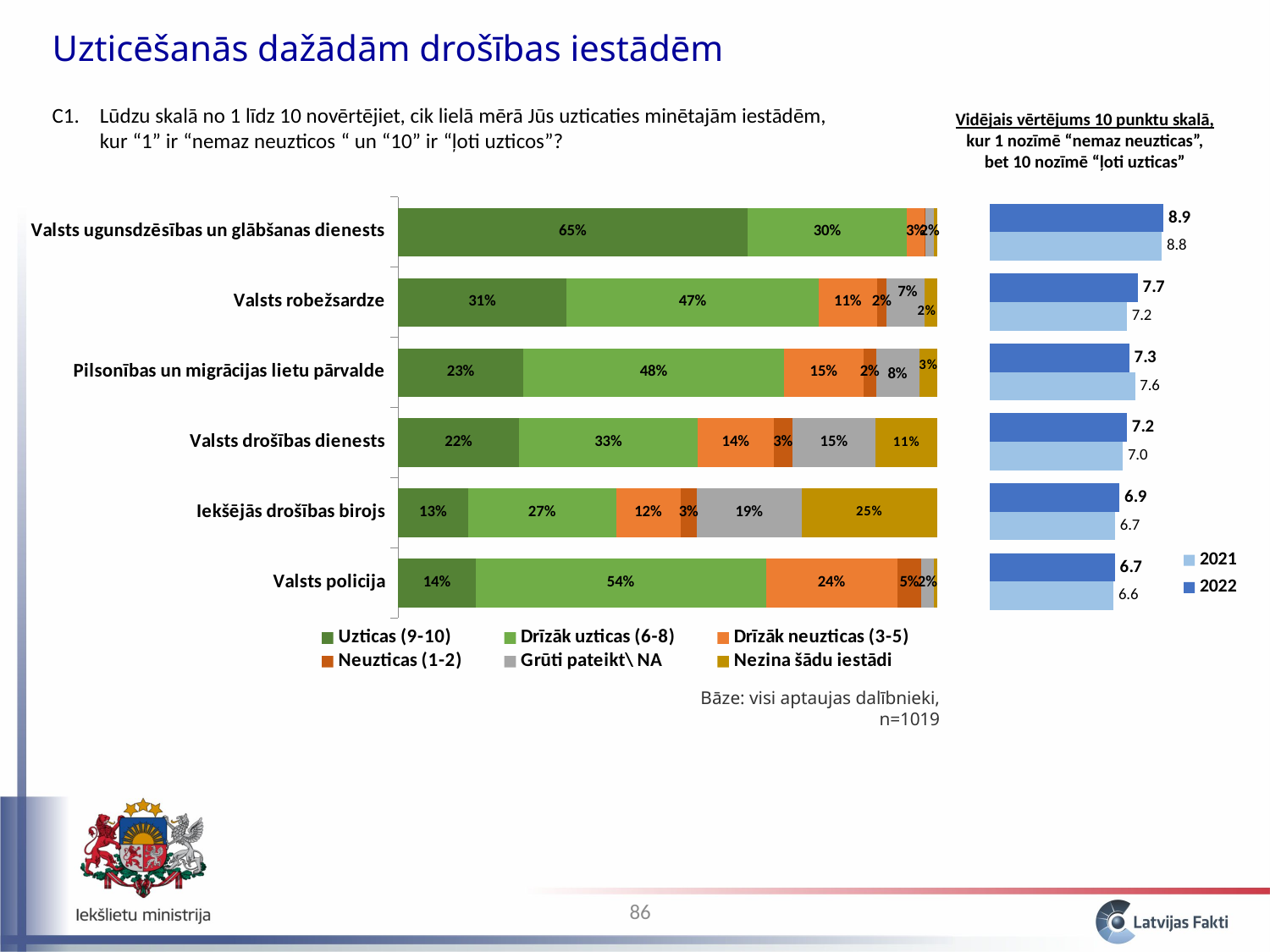
In the stacked bar chart on the left, what is the "Drīzāk uzticas (6-8)" value for Valsts policija? 54% In the average rating chart on the right, what is the 2022 value for Valsts robežsardze? 7.7 In the average rating chart on the right, which year has the higher value for Pilsonības un migrācijas lietu pārvalde, 2021 or 2022? 2021 In the stacked bar chart on the left, how many series does the legend list? 6 In the stacked bar chart on the left, what percentage of respondents answered "Uzticas (9-10)" for Valsts ugunsdzēsības un glābšanas dienests? 65% In the average rating chart on the right, which institution has the lowest 2022 value? Valsts policija In the stacked bar chart on the left, how many institutions are listed? 6 In the stacked bar chart on the left, what is the "Nezina šādu iestādi" value for Iekšējās drošības birojs? 25% In the stacked bar chart on the left, which institution has the highest "Uzticas (9-10)" share? Valsts ugunsdzēsības un glābšanas dienests What type of chart is the chart on the left of the slide? Bar chart In the average rating chart on the right, what is the difference between the 2022 and 2021 values for Valsts robežsardze? 0.5 In the average rating chart on the right, what is the 2021 value for Pilsonības un migrācijas lietu pārvalde? 7.6